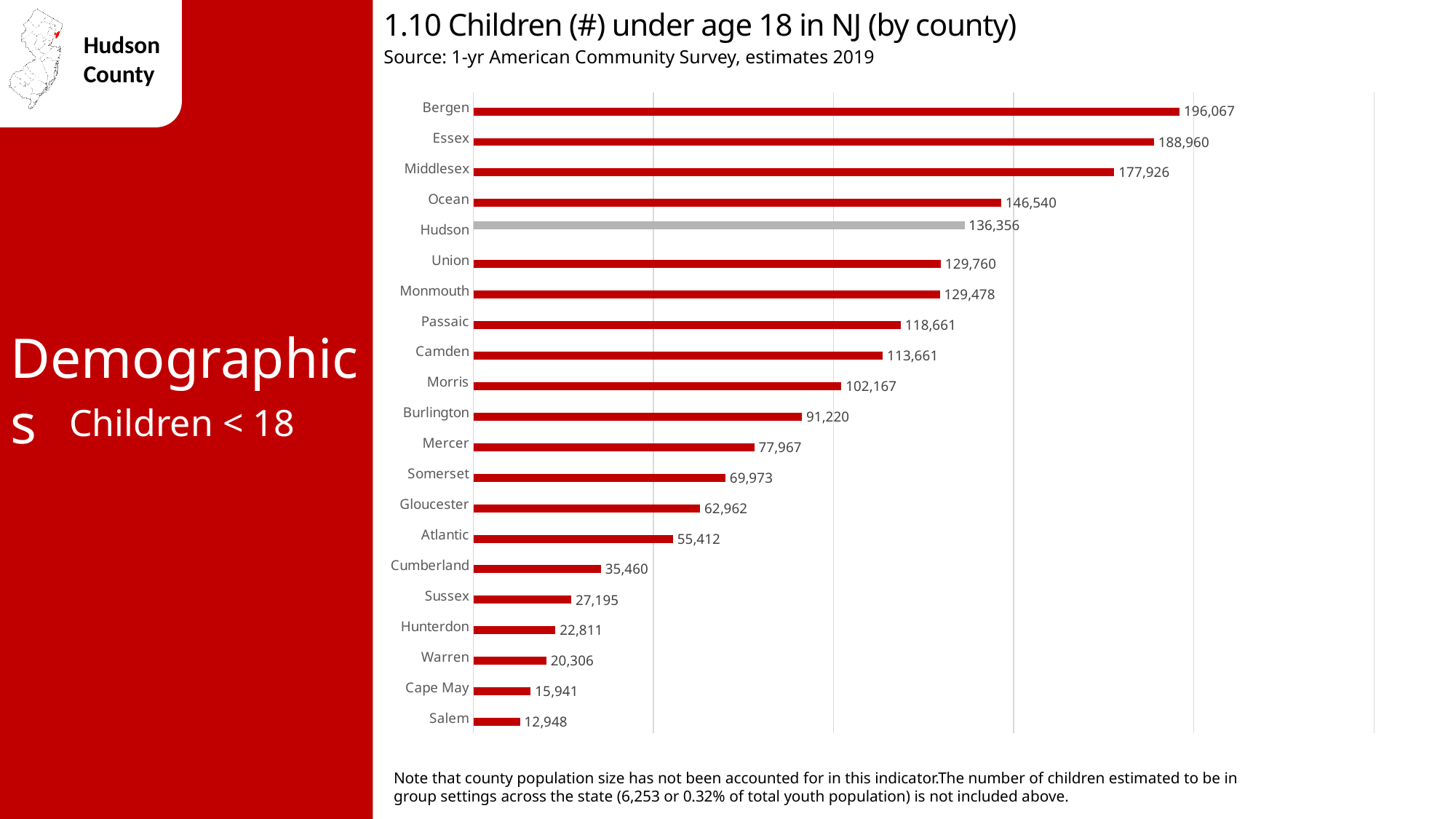
What is the difference between the number of children under 18 in Bergen and Essex counties? 7,107 What is the difference between the number of children under 18 in Hudson and Union counties? 6,596 Which county has the highest number of children under age 18? Bergen What type of chart is used on this slide? Bar chart What is the number of children under age 18 in Hudson County? 136,356 Which county has the lowest number of children under age 18? Salem Which county has more children under age 18, Mercer or Somerset? Mercer What is the number of children under age 18 in Cape May County? 15,941 Which county has more children under age 18, Ocean or Hudson? Ocean How many counties are shown in the chart? 21 What is the number of children under age 18 in Passaic County? 118,661 Which county's bar is shown in gray rather than red? Hudson